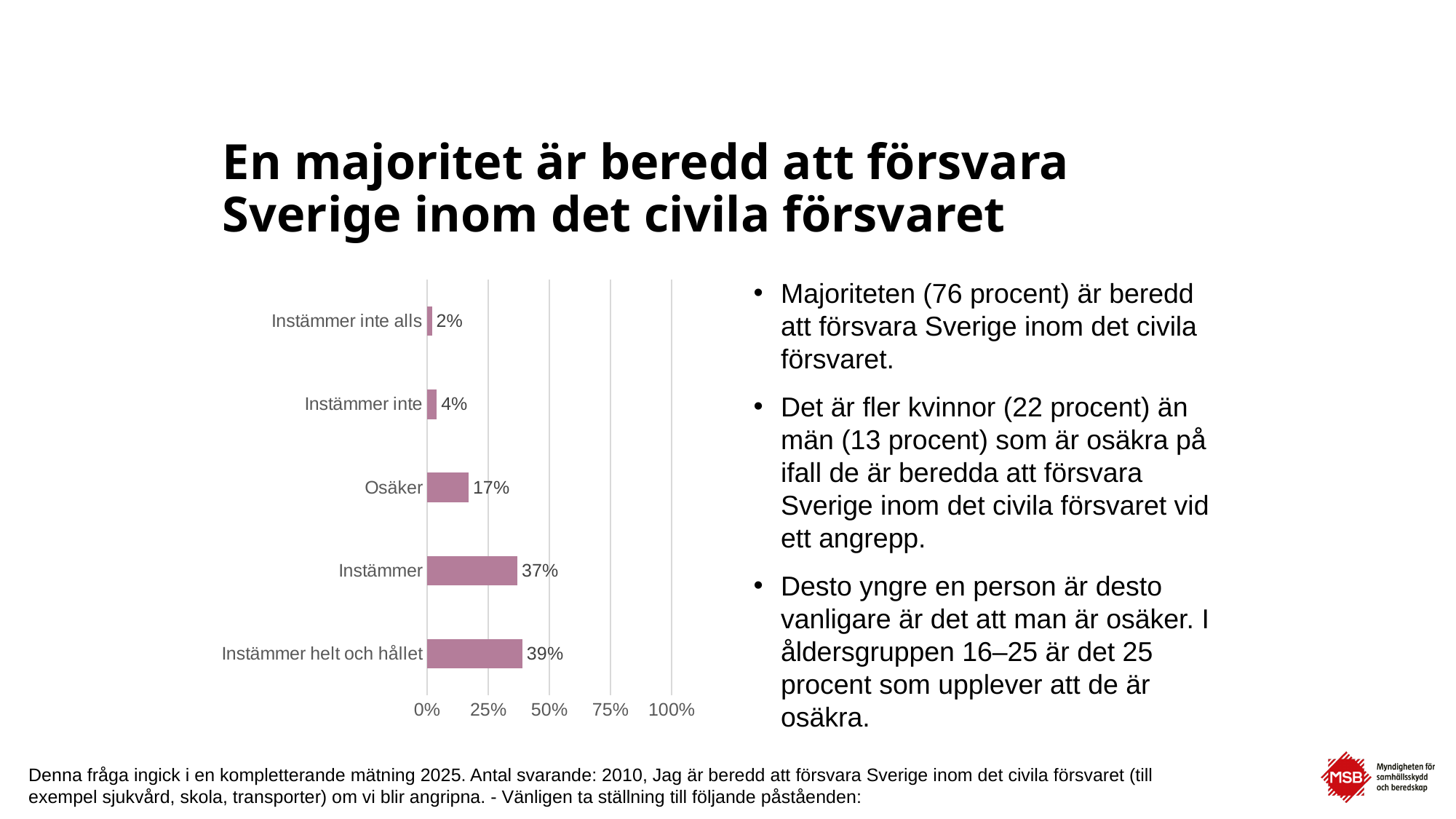
How many categories are shown in the chart? 5 What is the value for "Instämmer helt och hållet"? 39% What is the combined value of "Instämmer helt och hållet" and "Instämmer"? 76% Is the value for "Instämmer" greater or less than 25%? greater Which category has the highest value? Instämmer helt och hållet Which category has the lowest value? Instämmer inte alls What kind of chart is shown on the slide? Bar chart What is the difference between the values for "Instämmer" and "Osäker"? 20% What is the value for "Instämmer inte"? 4% What is the value for "Osäker"? 17% What is the value for "Instämmer inte alls"? 2% Which is larger, the value for "Osäker" or the value for "Instämmer inte"? Osäker